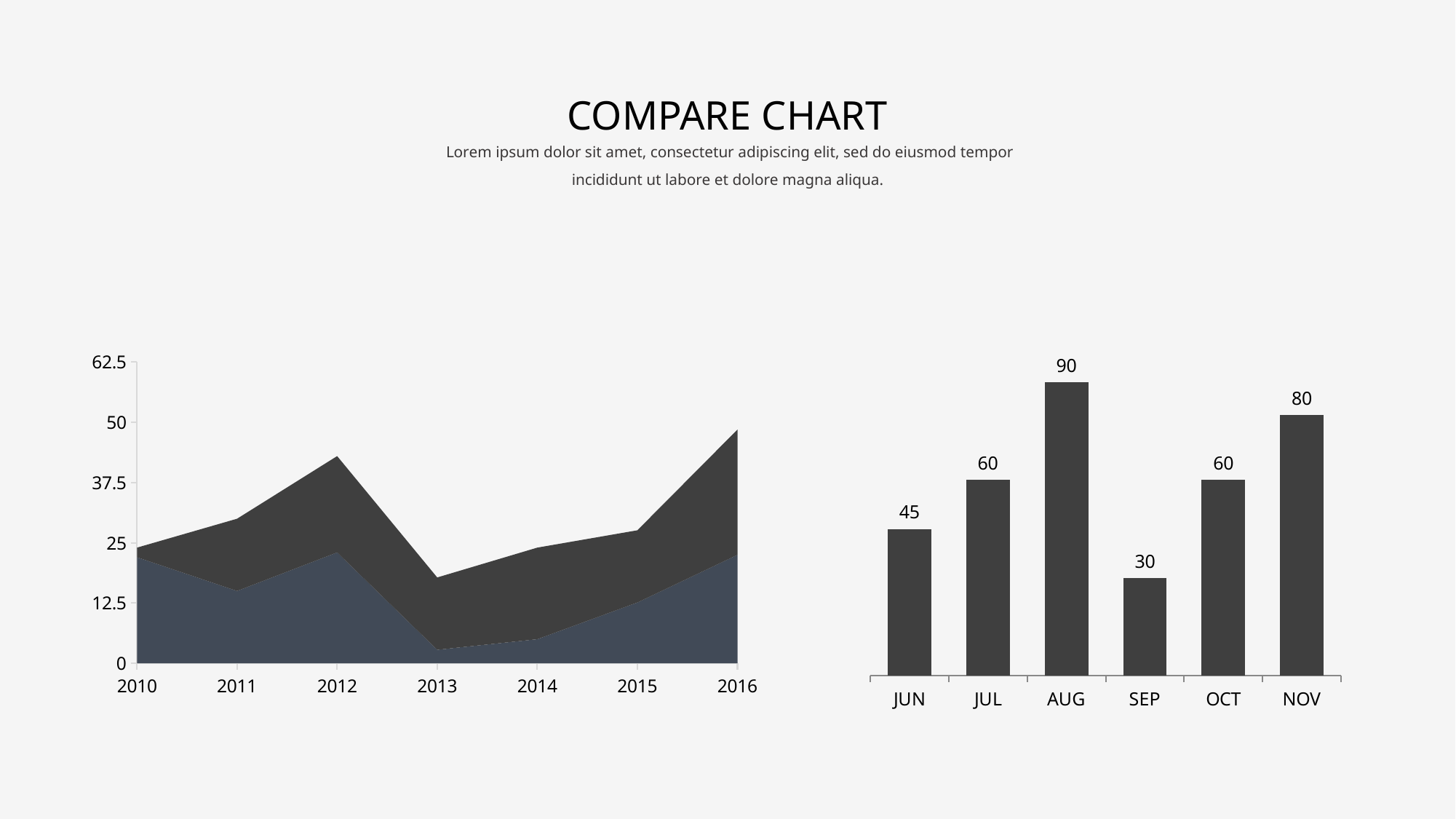
What kind of chart is the chart on the right of the slide? bar chart In the area chart on the left, is the top of the stacked area at 2012 greater or less than 37.5? greater What kind of chart is the chart on the left of the slide? area chart In the bar chart on the right, what is the value for AUG? 90 In the bar chart on the right, which is larger, the value for NOV or the value for JUN? NOV How many months are shown in the bar chart on the right? 6 In the bar chart on the right, what is the difference between the values for AUG and SEP? 60 In the bar chart on the right, which month has the lowest value? SEP In the bar chart on the right, what is the value for SEP? 30 How many years are shown on the x axis of the area chart on the left? 7 In the bar chart on the right, which month has the highest value? AUG In the area chart on the left, is the top of the stacked area at 2013 greater or less than 25? less